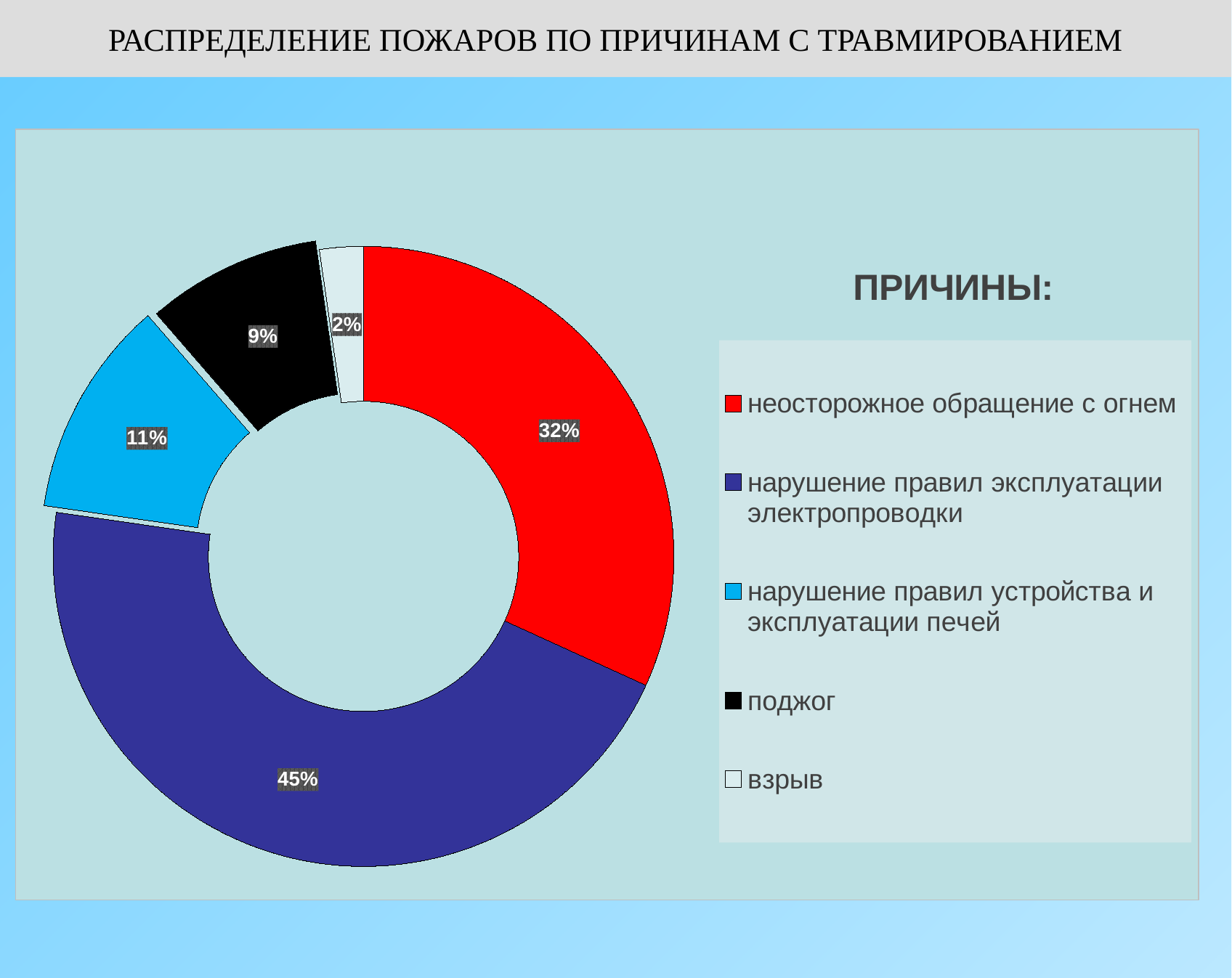
What is the value shown for поджог? 9% What share does взрыв account for? 2% What type of chart is shown on the slide? doughnut (pie) chart What percentage of the chart corresponds to неосторожное обращение с огнем? 32% How many causes are shown in the chart? 5 What colour represents нарушение правил устройства и эксплуатации печей in the chart? light blue What share of fires with injuries is attributed to нарушение правил эксплуатации электропроводки? 45% Which is larger: the share for нарушение правил устройства и эксплуатации печей or the share for поджог? нарушение правил устройства и эксплуатации печей Which cause has the largest share of fires with injuries? нарушение правил эксплуатации электропроводки Which cause has the smallest share? взрыв By how many percentage points does нарушение правил эксплуатации электропроводки exceed неосторожное обращение с огнем? 13 percentage points What is the combined share of поджог and взрыв? 11%